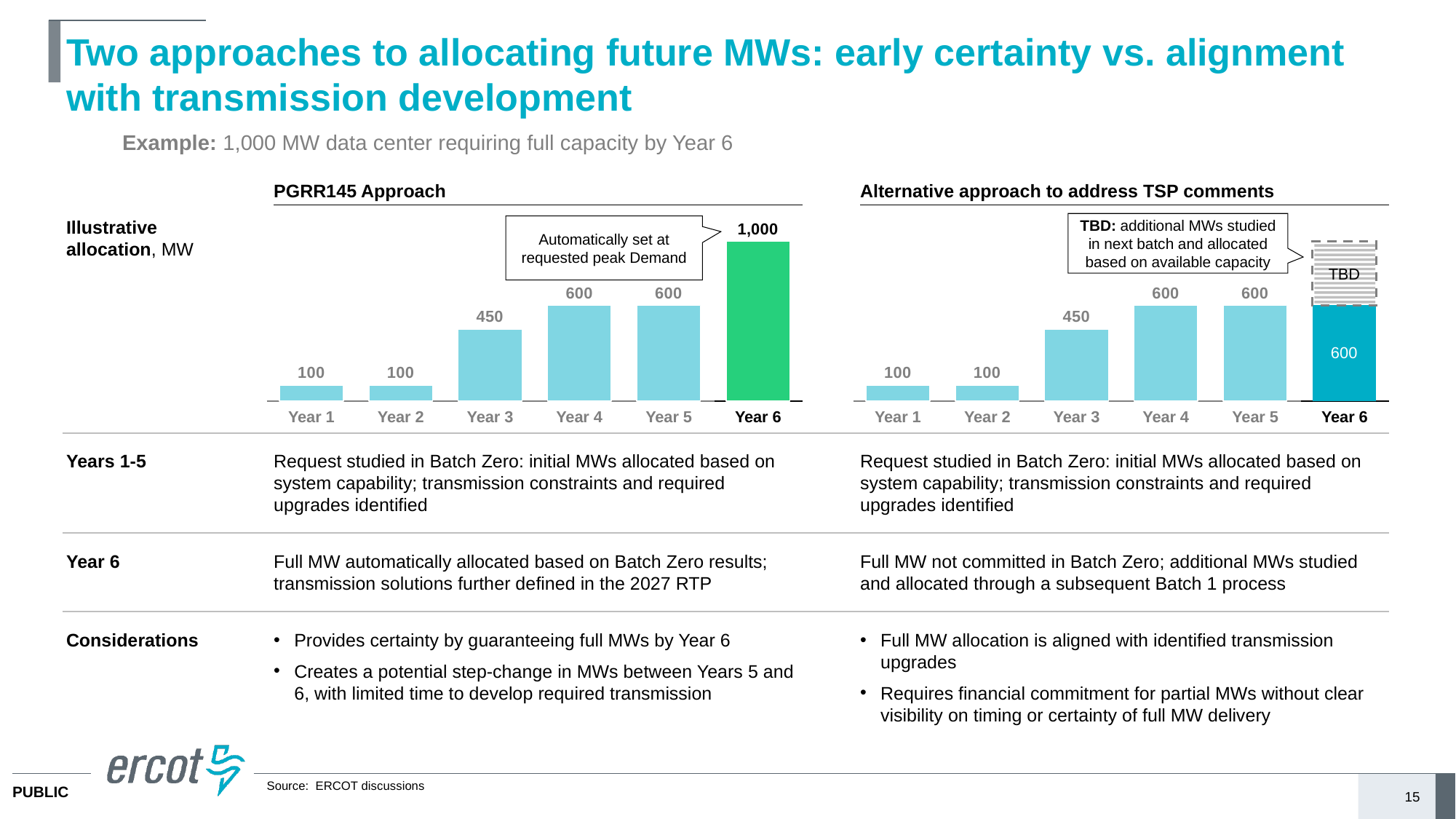
In the PGRR145 Approach chart, what is the illustrative allocation in Year 3? 450 In the PGRR145 Approach chart, which is larger, the Year 3 allocation or the Year 4 allocation? Year 4 In the PGRR145 Approach chart, what is the difference between the Year 6 and Year 5 allocations? 400 What unit is the illustrative allocation measured in on the charts? MW In the PGRR145 Approach chart, do the allocations rise or fall from Year 1 to Year 6? Rise In the Alternative approach chart, what is the committed allocation shown for Year 6? 600 In the PGRR145 Approach chart, what is the illustrative allocation in Year 6? 1,000 What kind of chart is the Alternative approach to address TSP comments chart? Bar chart In the Alternative approach chart, what label is shown on the dashed portion above the Year 6 bar? TBD In the Alternative approach chart, what is the difference between the Year 3 and Year 2 allocations? 350 How many years are shown on the x axis of the PGRR145 Approach chart? 6 In the PGRR145 Approach chart, which year has the highest allocation? Year 6